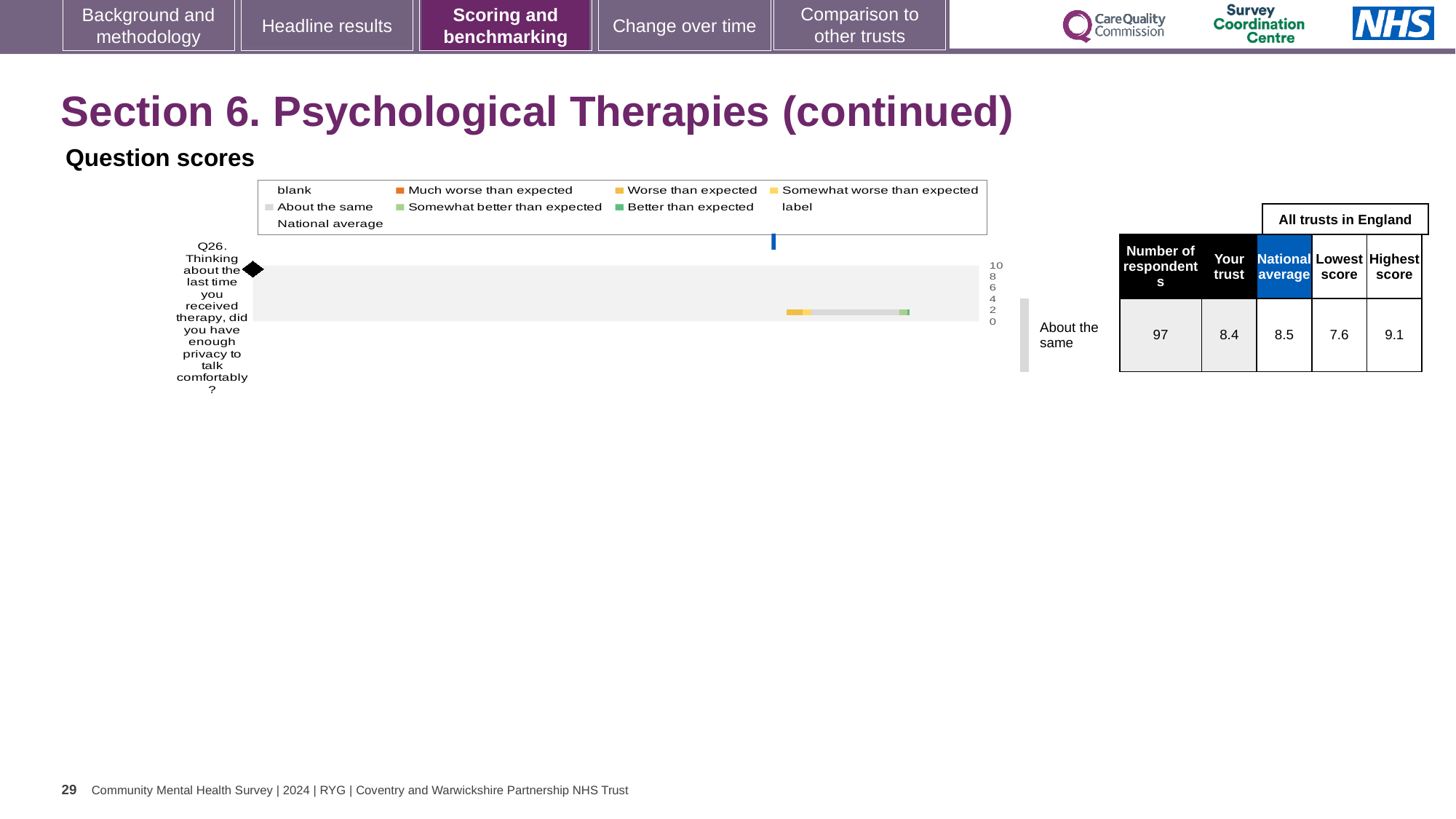
What is the national average score for Q26? 8.5 Which is larger for Q26, the 'Your trust' score or the national average? National average How many respondents answered Q26? 97 What is the highest score among all trusts in England for Q26? 9.1 What benchmark rating is shown for Q26? About the same Which question number is plotted in the Question scores chart? Q26 What type of chart is used to show the Q26 question score? bar chart What colour represents 'Much worse than expected' in the chart legend? Orange What is the 'Your trust' score for Q26? 8.4 What is the difference between the highest score and the lowest score for Q26? 1.5 How many survey questions are plotted in the Question scores chart? 1 What is the lowest score among all trusts in England for Q26? 7.6